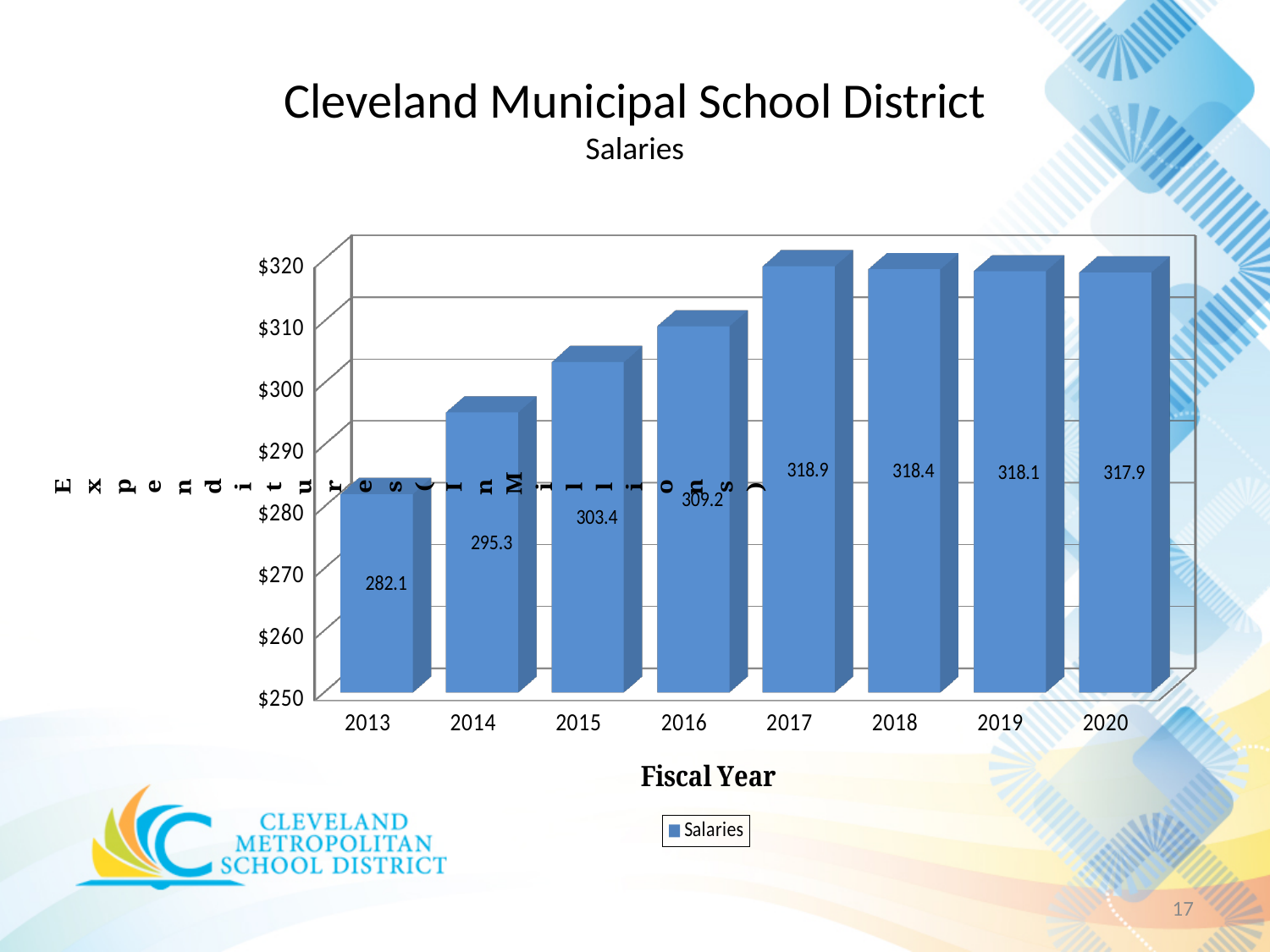
Which fiscal year has the lowest Salaries value? 2013 What kind of chart is shown on the slide? bar chart Which fiscal year has the highest Salaries value? 2017 How many fiscal years are shown on the x axis? 8 What is the difference between the Salaries values for 2017 and 2013? 36.8 What is the Salaries value for fiscal year 2020? 317.9 Which is larger, the Salaries value for 2016 or for 2015? 2016 Is the Salaries value for 2014 greater or less than $300? less What is the difference between the Salaries values for 2015 and 2014? 8.1 What is the Salaries value for fiscal year 2013? 282.1 What is the label of the x axis? Fiscal Year What is the Salaries value for fiscal year 2017? 318.9